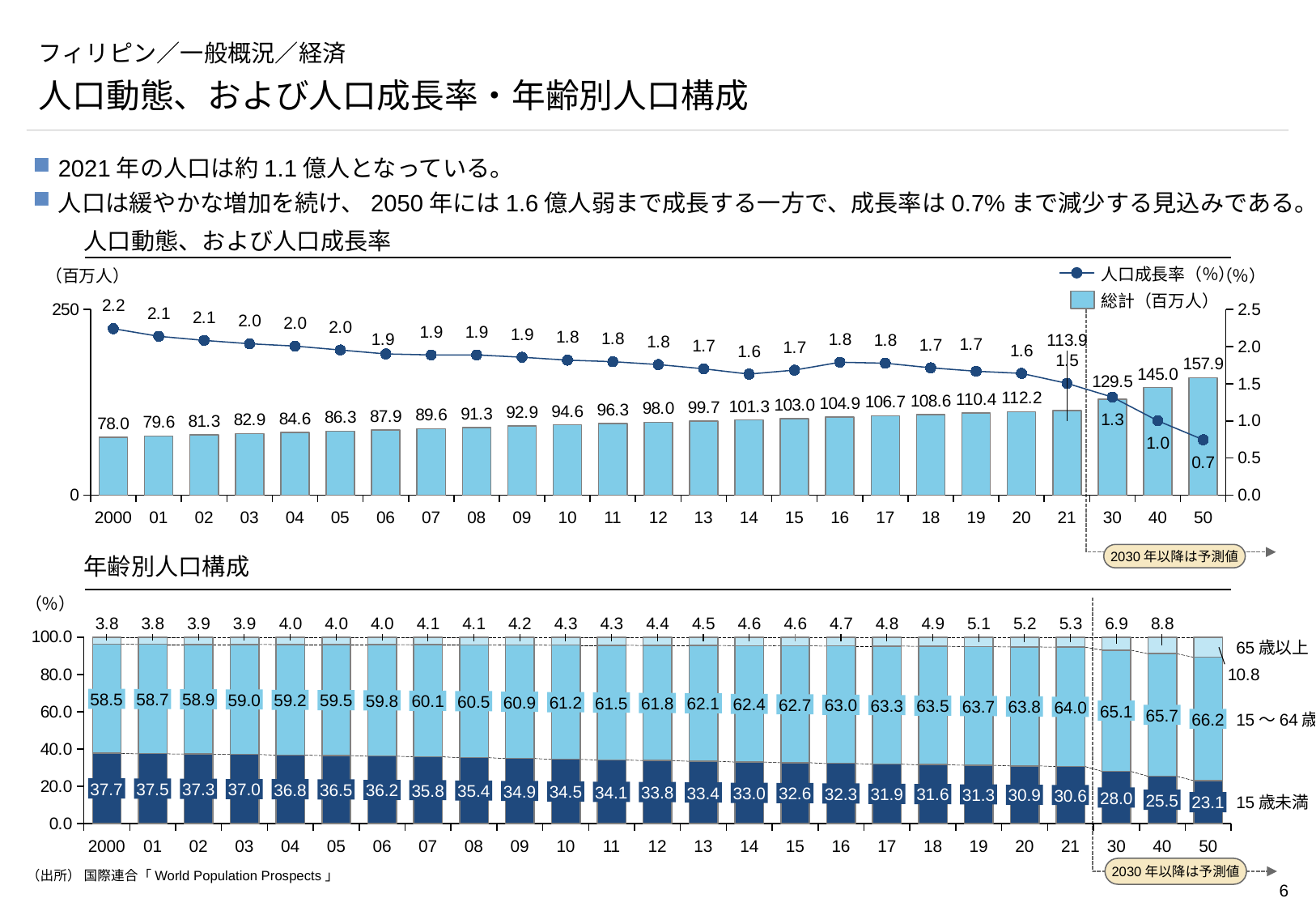
In the top chart (人口動態、および人口成長率), how many years (bars) are plotted? 25 In the top chart (人口動態、および人口成長率), which year has the lowest population growth rate? 50 (2050) In the top chart (人口動態、および人口成長率), what is the population growth rate (人口成長率) for 2000? 2.2 In the bottom chart (年齢別人口構成), what is the share of 15歳未満 in 2050? 23.1 What kind of chart is the bottom chart (年齢別人口構成)? Stacked bar chart In the bottom chart (年齢別人口構成), does the share of 15歳未満 rise or fall from 2000 to 2050? Fall In the top chart (人口動態、および人口成長率), which year has the highest total population? 50 (2050) In the top chart (人口動態、および人口成長率), how many series does the legend list? 2 In the bottom chart (年齢別人口構成), what is the share of 65歳以上 in 2040? 8.8 In the top chart (人口動態、および人口成長率), how much larger is the total population in 2050 than in 2000? 79.9 In the top chart (人口動態、および人口成長率), what is the total population (総計) for 2021? 112.2 In the top chart (人口動態、および人口成長率), which year has the higher population growth rate, 2030 or 2040? 2030